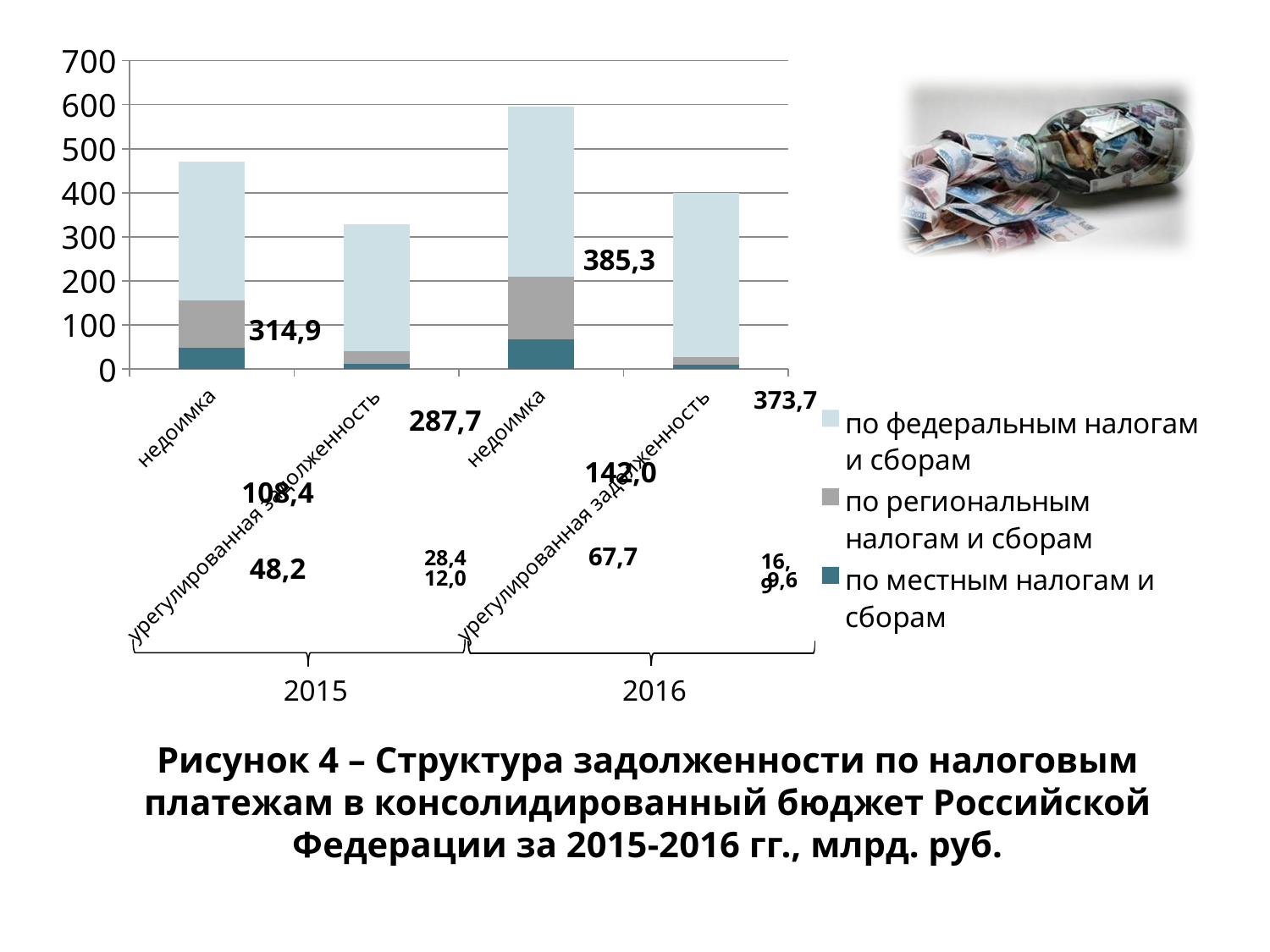
Which bar is the shortest in the chart? урегулированная задолженность 2015 What is the value for по федеральным налогам и сборам for недоимка in 2016? 385,3 Which legend entry is shown in the darkest colour? по местным налогам и сборам Which bar is the tallest in the chart? недоимка 2016 What is the value for по федеральным налогам и сборам for недоимка in 2015? 314,9 How many series does the legend list? 3 Is the total for урегулированная задолженность in 2016 greater or less than 500? less Which is larger: the total for недоимка in 2016 or the total for недоимка in 2015? недоимка in 2016 What kind of chart is shown on the slide? stacked bar chart What is the unit of measurement stated in the figure caption? млрд. руб. Is the total for недоимка in 2015 greater or less than 400? greater How many bars are plotted in the chart? 4